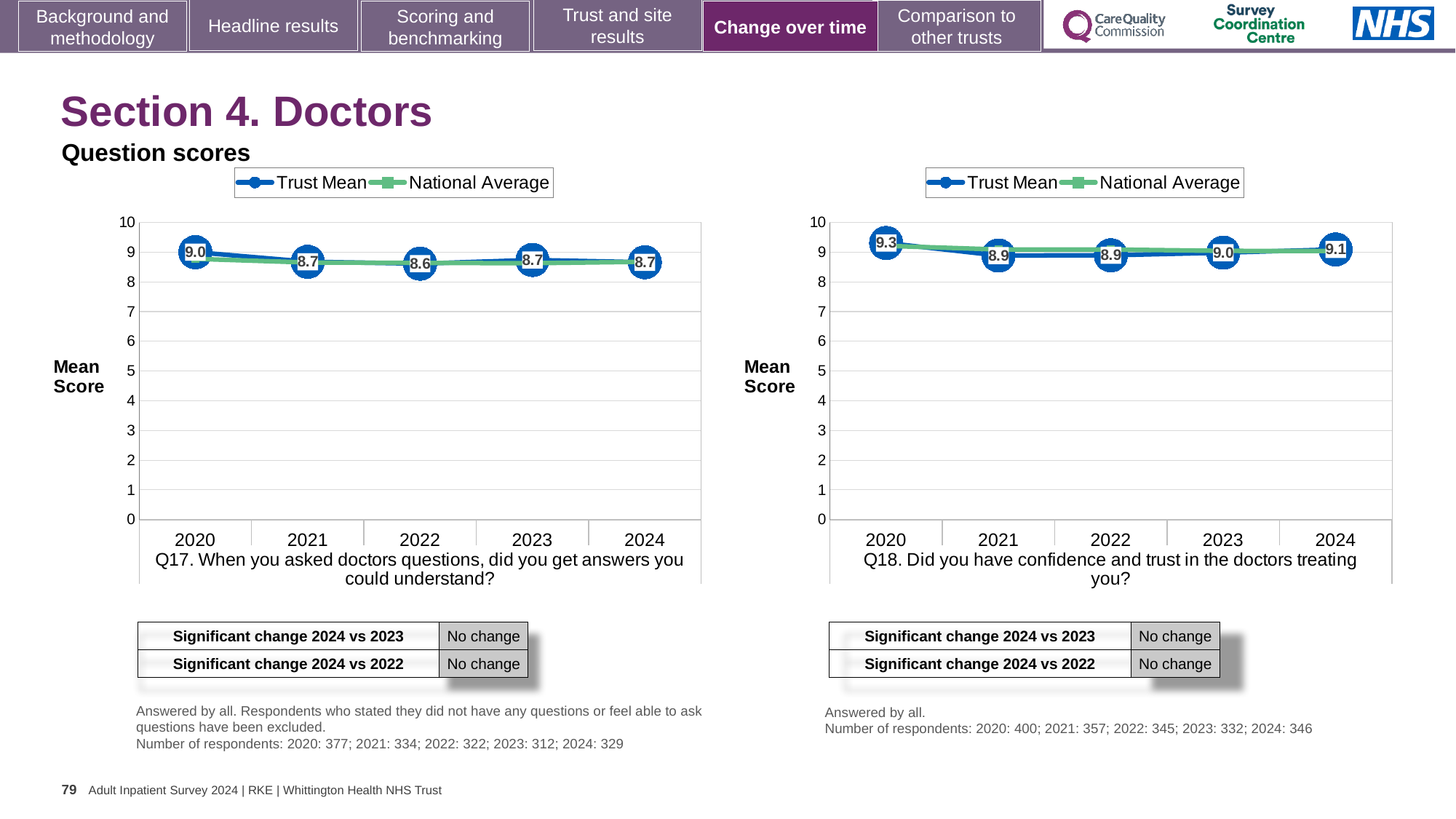
What type of chart is the Q18 chart (right)? Line chart On the Q18 chart (right), which year has the lowest Trust Mean score? 2021 and 2022 On the Q18 chart (right), what is the difference between the Trust Mean scores for 2020 and 2021? 0.4 On the Q18 chart (right), what is the Trust Mean score for 2021? 8.9 On the Q17 chart (left), is the Trust Mean score for 2020 or 2022 larger? 2020 On the Q17 chart (left), is the National Average value for 2024 greater or less than 8? greater On the Q18 chart (right), what is the Trust Mean score for 2024? 9.1 On the Q17 chart (left), what is the Trust Mean score for 2020? 9.0 On the Q17 chart (left), what is the Trust Mean score for 2022? 8.6 How many series does the legend of the Q17 chart (left) list? 2 On the Q17 chart (left), which year has the highest Trust Mean score? 2020 How many years are plotted on the Q18 chart (right)? 5